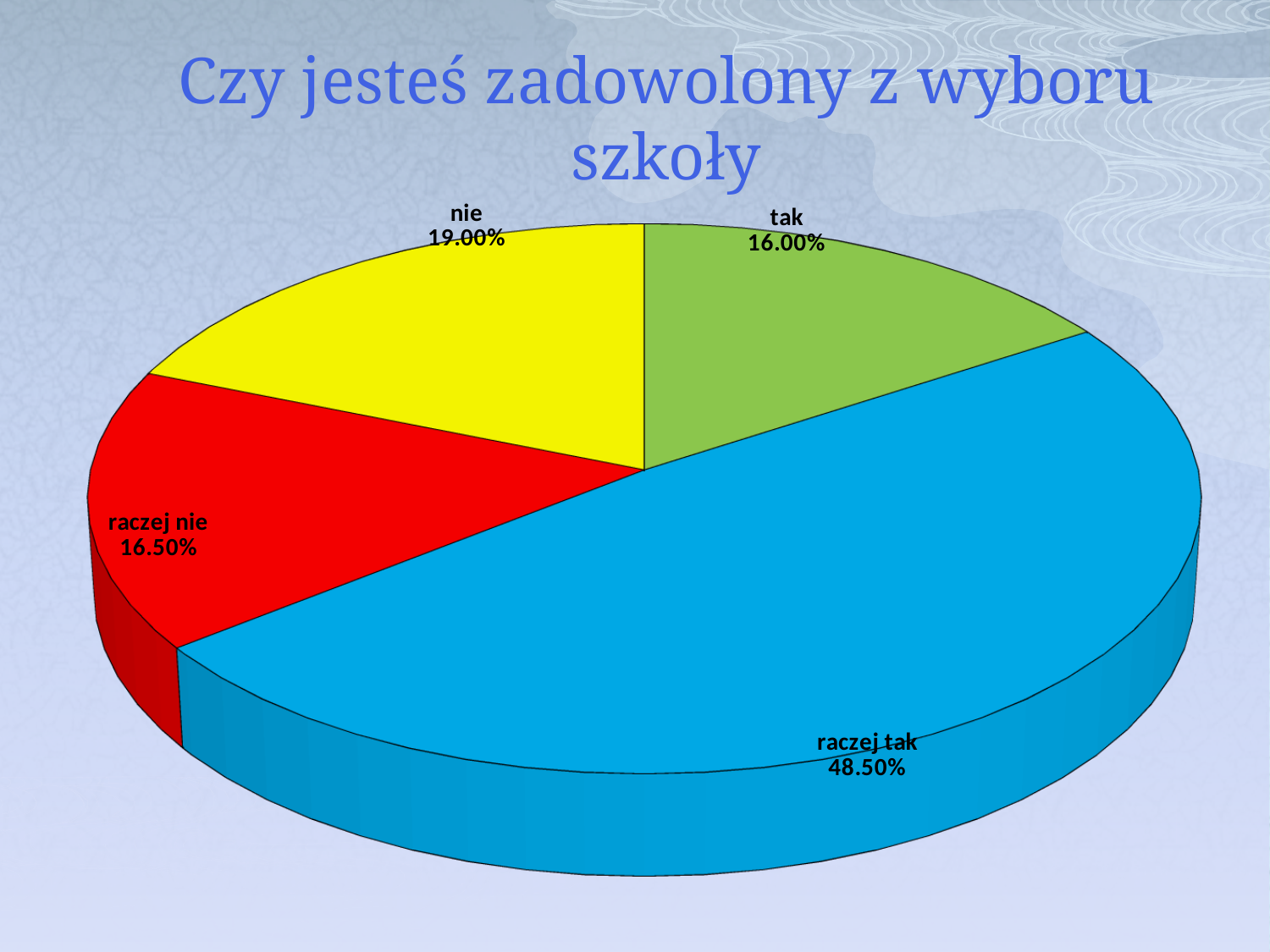
What is the value for "raczej tak"? 48.50% How many categories are shown in the pie chart? 4 Which category has the smallest share of the pie? tak What is the title of the chart? Czy jesteś zadowolony z wyboru szkoły What is the value for "raczej nie"? 16.50% What is the value for "nie"? 19.00% What is the difference between the values for "raczej nie" and "tak"? 0.50% Which is larger, the value for "nie" or the value for "raczej nie"? nie What is the value for "tak"? 16.00% Which category has the largest share of the pie? raczej tak What is the difference between the values for "raczej tak" and "nie"? 29.50% What type of chart is shown on the slide? pie chart